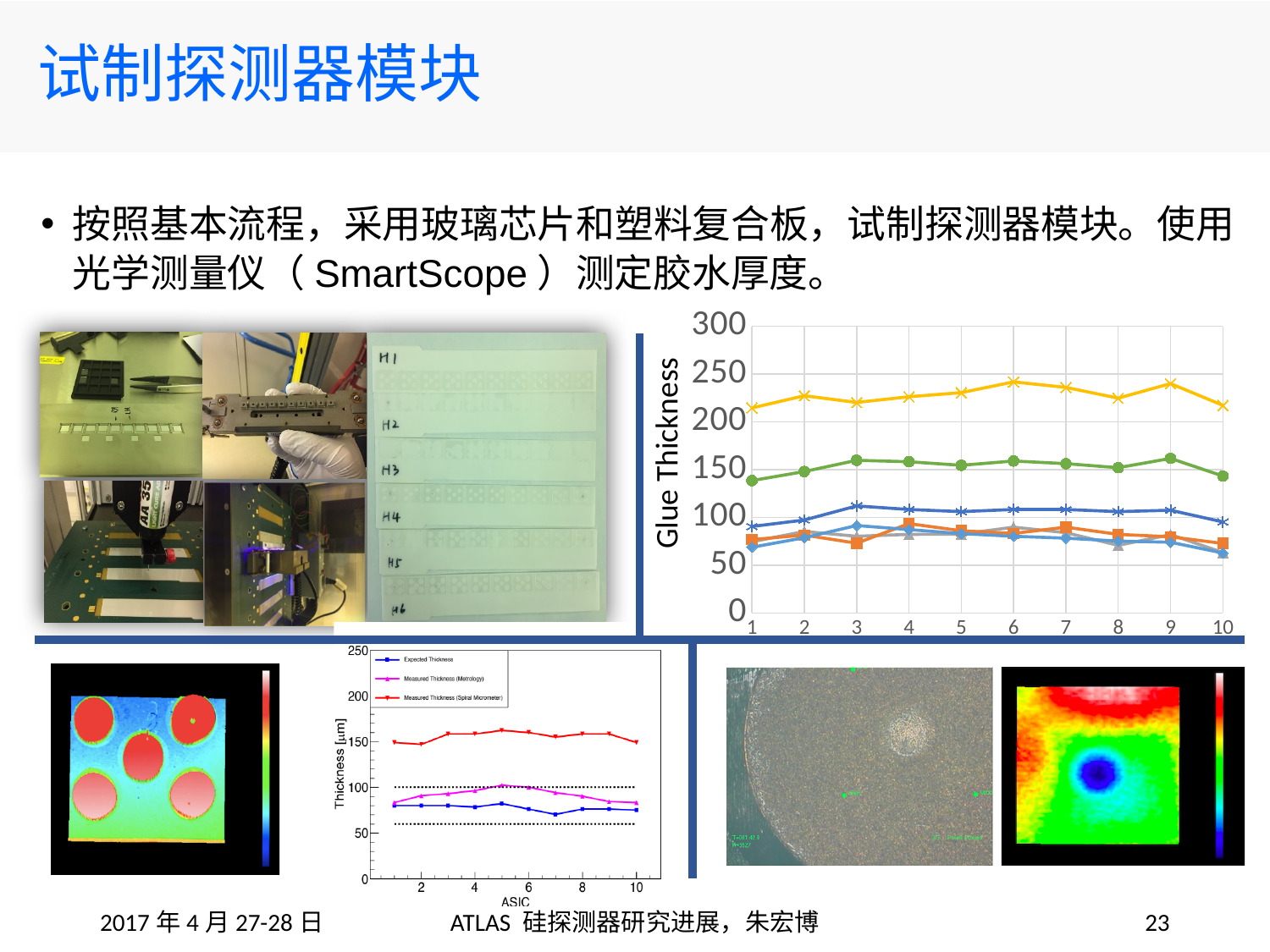
In the Glue Thickness chart, is the value of the green series at x = 1 greater or less than 150? less In the Glue Thickness chart, how many points are plotted along the x axis for each series? 10 In the Glue Thickness chart, is the value of the yellow series at x = 6 greater or less than 200? greater How many series does the legend list in the small chart at the bottom left with the x axis labelled ASIC? 3 In the small chart with the x axis labelled ASIC, is the Measured Thickness (Spiral Micrometer) value at ASIC 5 greater or less than 150? greater What is the label of the y axis on the large chart on the right side of the slide? Glue Thickness In the small chart with the x axis labelled ASIC, which series has the highest values? Measured Thickness (Spiral Micrometer) In the Glue Thickness chart, which is larger at x = 3: the yellow series or the green series? the yellow series In the small chart with the x axis labelled ASIC, which is larger at ASIC 5: Measured Thickness (Metrology) or Expected Thickness? Measured Thickness (Metrology) In the Glue Thickness chart, which series has the highest values across the x axis? the yellow series with x markers What kind of chart is the large chart on the right side of the slide with the y-axis labelled Glue Thickness? line chart